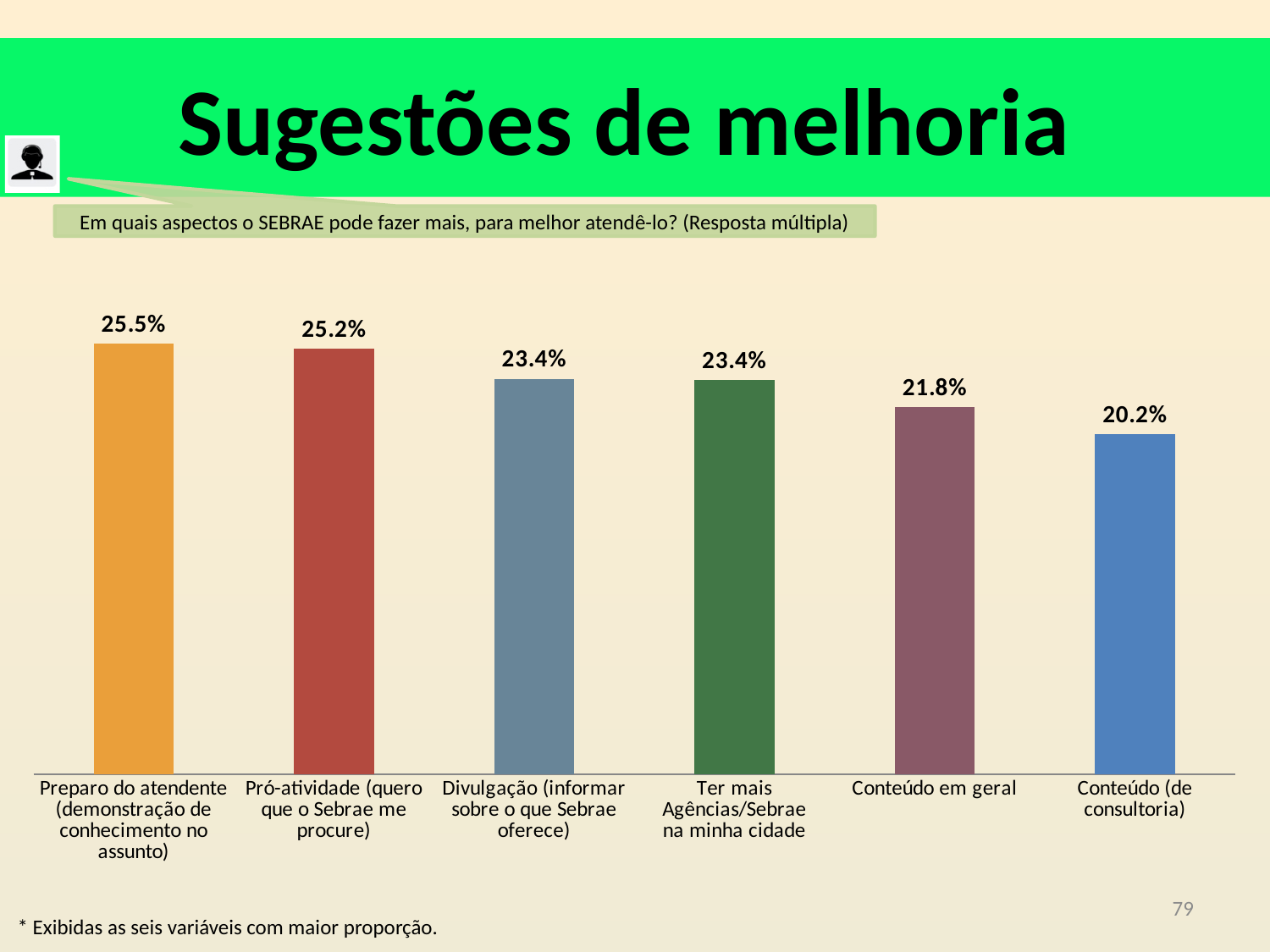
What is the difference between the values for "Divulgação (informar sobre o que Sebrae oferece)" and "Conteúdo em geral"? 1.6% What is the value for "Conteúdo (de consultoria)"? 20.2% Do the values rise or fall from left to right across the categories? Fall Which category has the highest value? Preparo do atendente (demonstração de conhecimento no assunto) Which category has the lowest value? Conteúdo (de consultoria) What is the difference between the values for "Preparo do atendente" and "Conteúdo (de consultoria)"? 5.3% What is the value for "Pró-atividade (quero que o Sebrae me procure)"? 25.2% How many categories are shown in the chart? 6 What is the value for "Ter mais Agências/Sebrae na minha cidade"? 23.4% What kind of chart is shown on the slide? Bar chart Which is larger: the value for "Conteúdo em geral" or the value for "Conteúdo (de consultoria)"? Conteúdo em geral What is the value for "Conteúdo em geral"? 21.8%